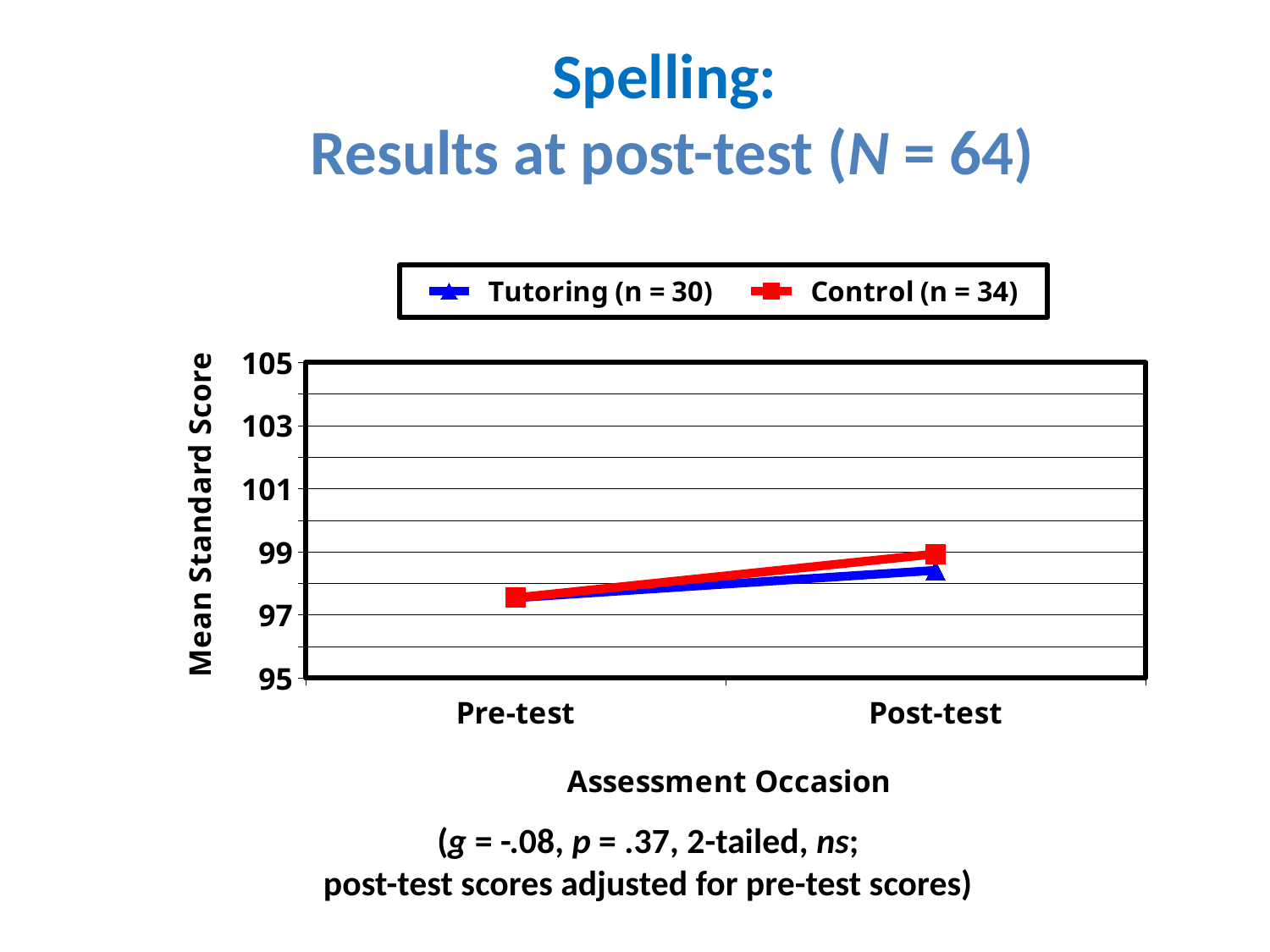
Do the Tutoring (n = 30) scores rise or fall from Pre-test to Post-test? rise Which series is drawn in red? Control (n = 34) How many series does the legend list? 2 How many assessment occasions are plotted on the x axis? 2 Is the Pre-test value for Control (n = 34) greater or less than 99? less Is the Post-test value for Control (n = 34) greater or less than 101? less Is the Post-test value for Tutoring (n = 30) greater or less than 101? less What kind of chart is shown on the slide? line chart What is the title of the y axis? Mean Standard Score At Post-test, which series has the higher mean standard score, Tutoring (n = 30) or Control (n = 34)? Control (n = 34) Do the Control (n = 34) scores rise or fall from Pre-test to Post-test? rise